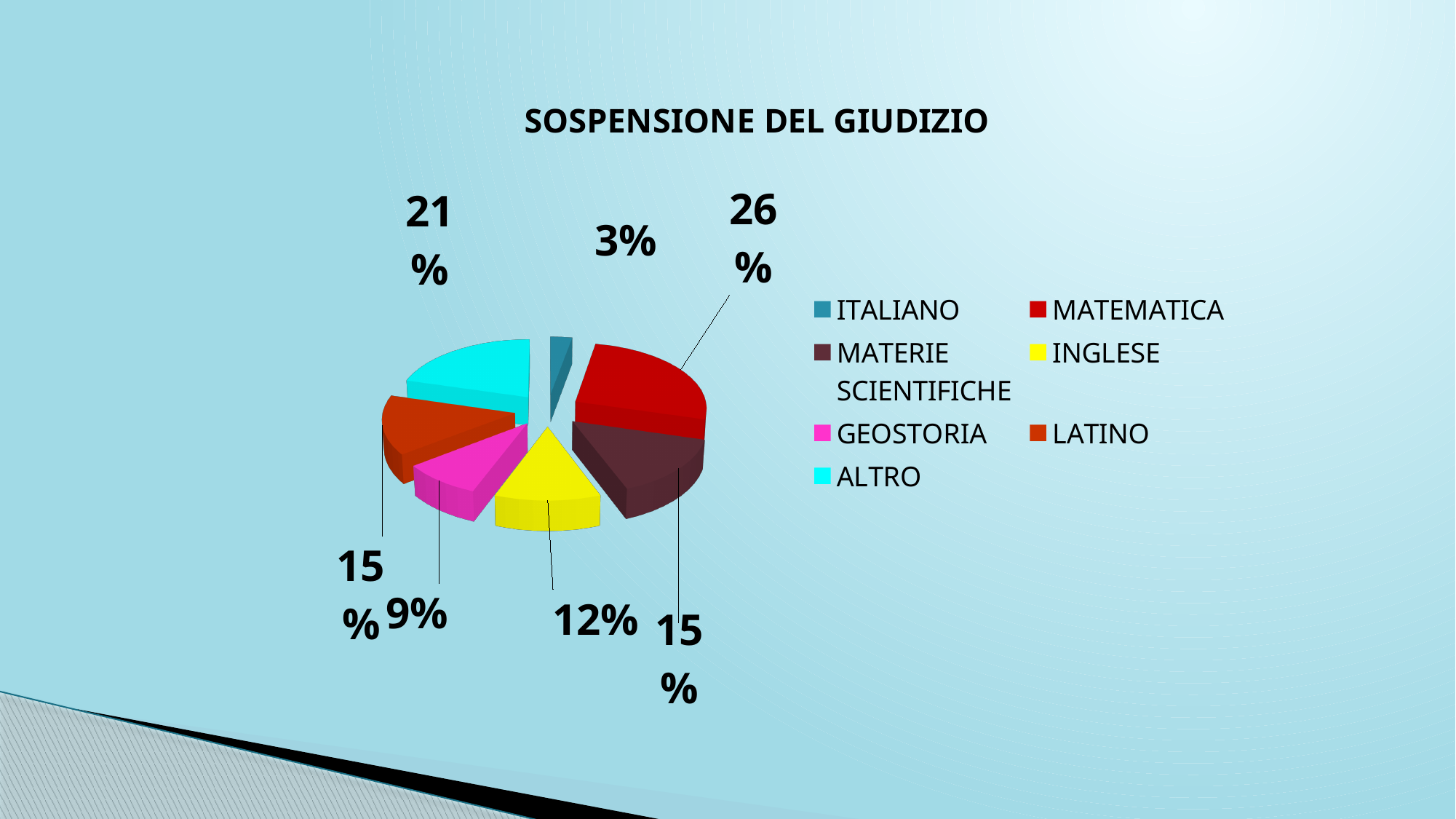
What percentage of the pie does INGLESE represent? 12% How many categories does the legend list? 7 What percentage of the pie does ITALIANO represent? 3% What percentage of the pie does GEOSTORIA represent? 9% Which has a larger share, INGLESE or GEOSTORIA? INGLESE What kind of chart is shown on the slide? pie chart What percentage of the pie does MATEMATICA represent? 26% What is the title of the chart? SOSPENSIONE DEL GIUDIZIO What is the difference in percentage points between MATEMATICA and ALTRO? 5 Which category has the largest share of the pie? MATEMATICA Which category has the smallest share of the pie? ITALIANO What percentage of the pie does ALTRO represent? 21%